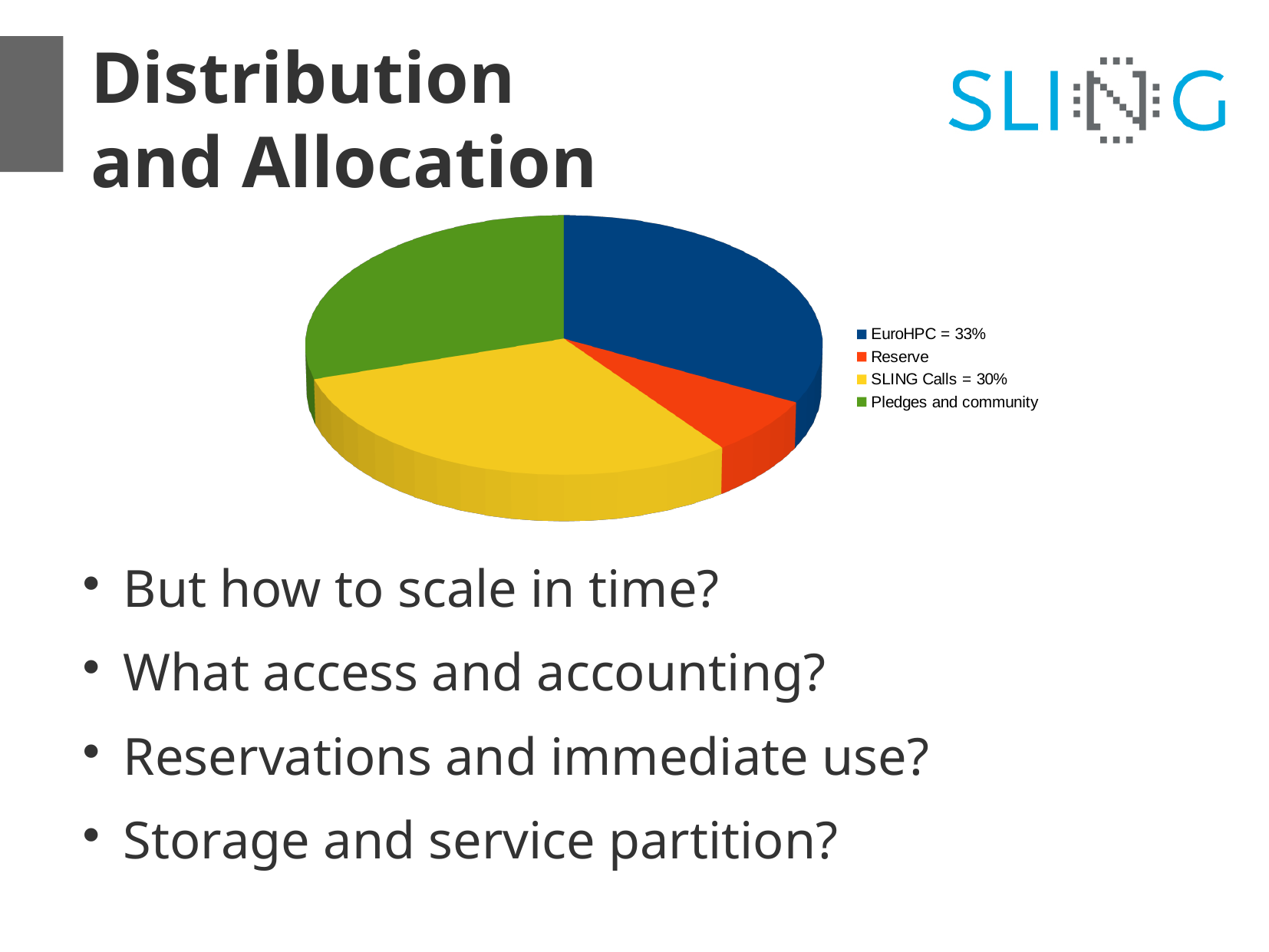
How many entries does the pie chart's legend list? 4 Which is larger, the Reserve slice or the Pledges and community slice? Pledges and community Which is larger, the Reserve slice or the SLING Calls slice? SLING Calls What colour is the SLING Calls slice in the pie chart? Yellow Which slice of the pie chart is the smallest? Reserve What kind of chart is shown on the slide? Pie chart Which legend entry is shown in green? Pledges and community How many slices does the pie chart have? 4 What share of the pie does SLING Calls have, according to the legend? 30% Which is larger, the EuroHPC slice or the SLING Calls slice? EuroHPC What share of the pie does EuroHPC have, according to the legend? 33% By how many percentage points does the EuroHPC share exceed the SLING Calls share? 3 percentage points